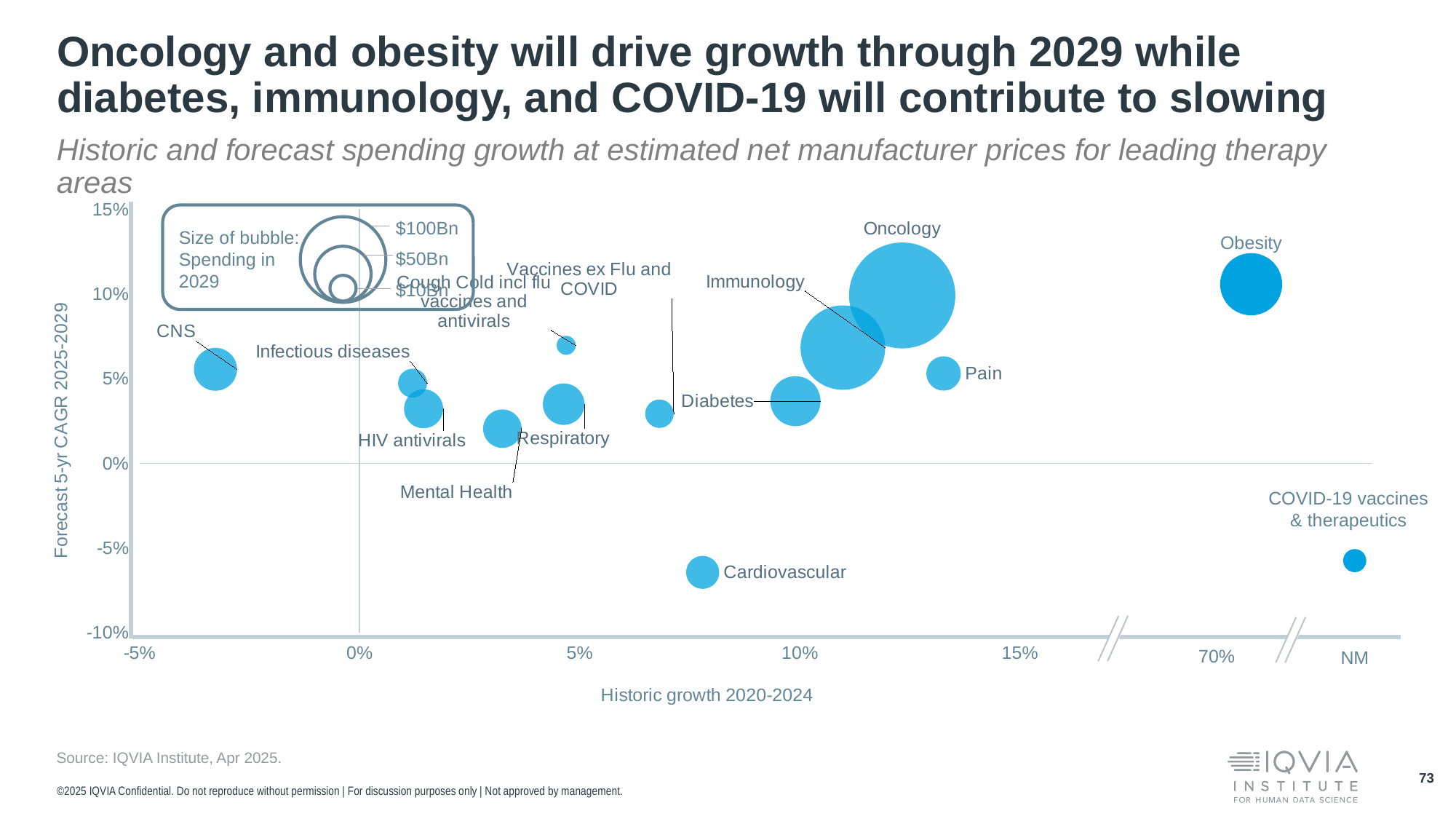
Which has the larger bubble, Immunology or Pain? Immunology Is the forecast 5-yr CAGR 2025-2029 for Cardiovascular greater or less than 0%? less Is the forecast 5-yr CAGR 2025-2029 for Oncology greater or less than 5%? greater What kind of chart is shown on the slide? Bubble chart What does the size of each bubble represent according to the legend? Spending in 2029 Is the historic growth 2020-2024 for CNS greater or less than 0%? less How many therapy-area bubbles are plotted on the chart? 14 Which therapy area has the largest bubble (highest spending in 2029)? Oncology Which has the higher forecast 5-yr CAGR 2025-2029, Oncology or Cardiovascular? Oncology What is the title of the horizontal axis? Historic growth 2020-2024